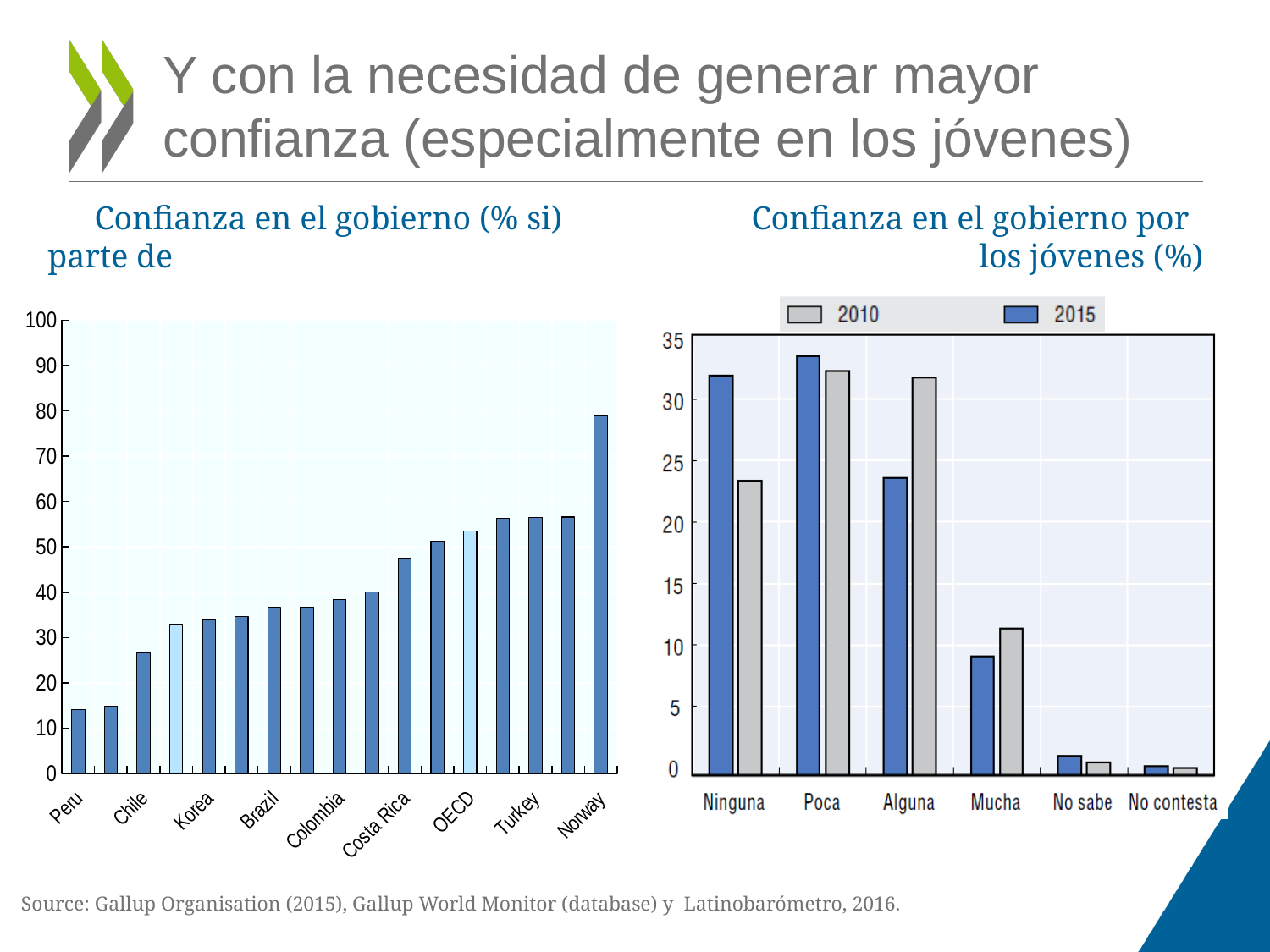
How many categories are shown on the x axis of the right chart, 'Confianza en el gobierno por los jóvenes (%)'? 6 In the left chart, 'Confianza en el gobierno (% si) parte de', do the bar values generally rise or fall from left to right? rise What kind of chart is the left chart, 'Confianza en el gobierno (% si) parte de'? bar chart In the left chart, 'Confianza en el gobierno (% si) parte de', is the value for Peru greater or less than 20? less In the left chart, 'Confianza en el gobierno (% si) parte de', which labelled country has the highest value? Norway In the left chart, 'Confianza en el gobierno (% si) parte de', which labelled country has the lowest value? Peru In the right chart, 'Confianza en el gobierno por los jóvenes (%)', which is larger for Alguna, the 2010 value or the 2015 value? 2010 In the right chart, 'Confianza en el gobierno por los jóvenes (%)', is the 2015 value for Ninguna greater or less than 30? greater In the left chart, 'Confianza en el gobierno (% si) parte de', is the value for Costa Rica greater or less than 40? greater How many series does the legend of the right chart, 'Confianza en el gobierno por los jóvenes (%)', list? 2 In the right chart, 'Confianza en el gobierno por los jóvenes (%)', which colour represents the 2015 series? blue